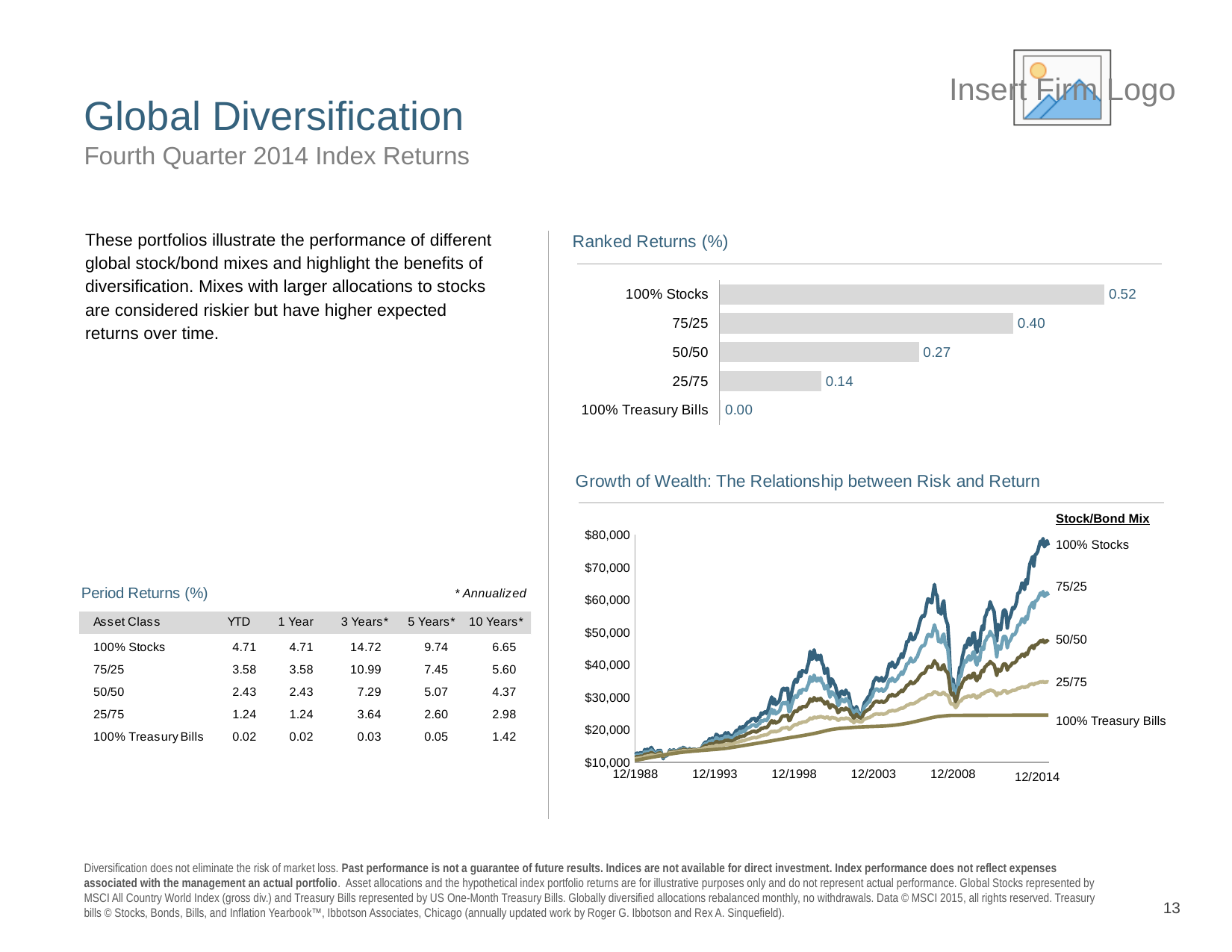
How many stock/bond mixes are plotted in the Growth of Wealth chart? 5 In the Ranked Returns (%) chart, which portfolio has the lowest return? 100% Treasury Bills In the Ranked Returns (%) chart, what is the difference between the values for 75/25 and 25/75? 0.26 In the Ranked Returns (%) chart, which portfolio has the highest return? 100% Stocks What kind of chart is the Growth of Wealth chart? Line chart How many portfolios are shown in the Ranked Returns (%) chart? 5 What kind of chart is the Ranked Returns (%) chart? Bar chart In the Ranked Returns (%) chart, which is larger, the value for 50/50 or the value for 25/75? 50/50 In the Ranked Returns (%) chart, what is the value for 50/50? 0.27 In the Ranked Returns (%) chart, what is the value for 100% Treasury Bills? 0.00 In the Growth of Wealth chart, is the ending value of the 100% Stocks line at 12/2014 greater or less than $70,000? greater In the Ranked Returns (%) chart, what is the value for 100% Stocks? 0.52